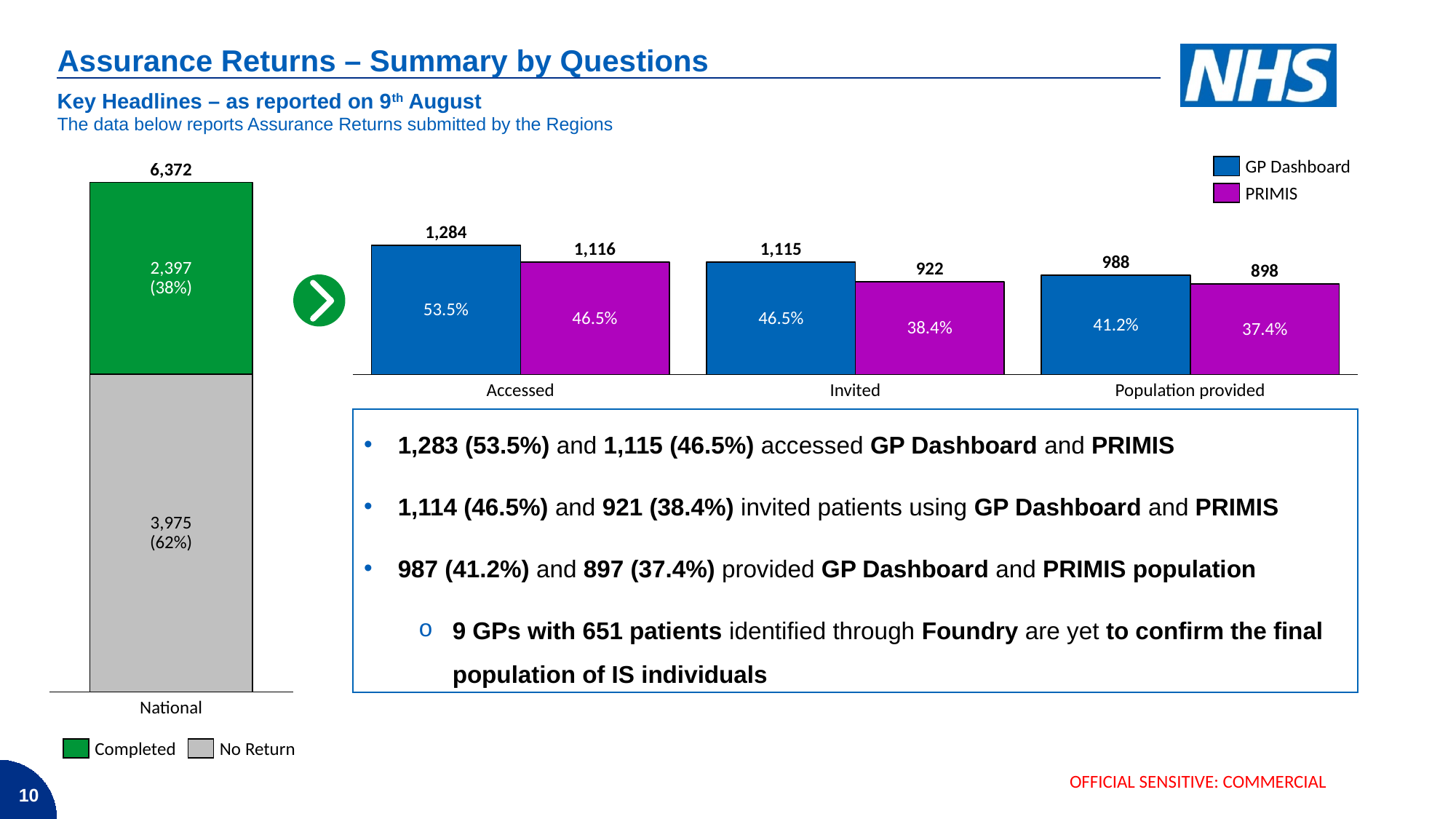
In the right-hand grouped bar chart, what percentage is shown on the PRIMIS bar for Population provided? 37.4% In the left-hand stacked bar chart, what is the total of the National bar? 6,372 In the right-hand grouped bar chart, which category has the highest GP Dashboard value? Accessed In the left-hand stacked bar chart, what is the Completed value for National? 2,397 (38%) How many series does the legend of the right-hand grouped bar chart list? 2 In the left-hand stacked bar chart, what is the No Return value for National? 3,975 (62%) In the right-hand grouped bar chart, what is the PRIMIS value for Invited? 922 In the right-hand grouped bar chart, do the GP Dashboard values rise or fall from Accessed to Population provided? fall In the right-hand grouped bar chart, what is the difference between the GP Dashboard and PRIMIS values for Accessed? 168 In the right-hand grouped bar chart, which category has the lowest PRIMIS value? Population provided In the right-hand grouped bar chart, what is the GP Dashboard value for Accessed? 1,284 In the left-hand stacked bar chart, which segment is larger for National, Completed or No Return? No Return